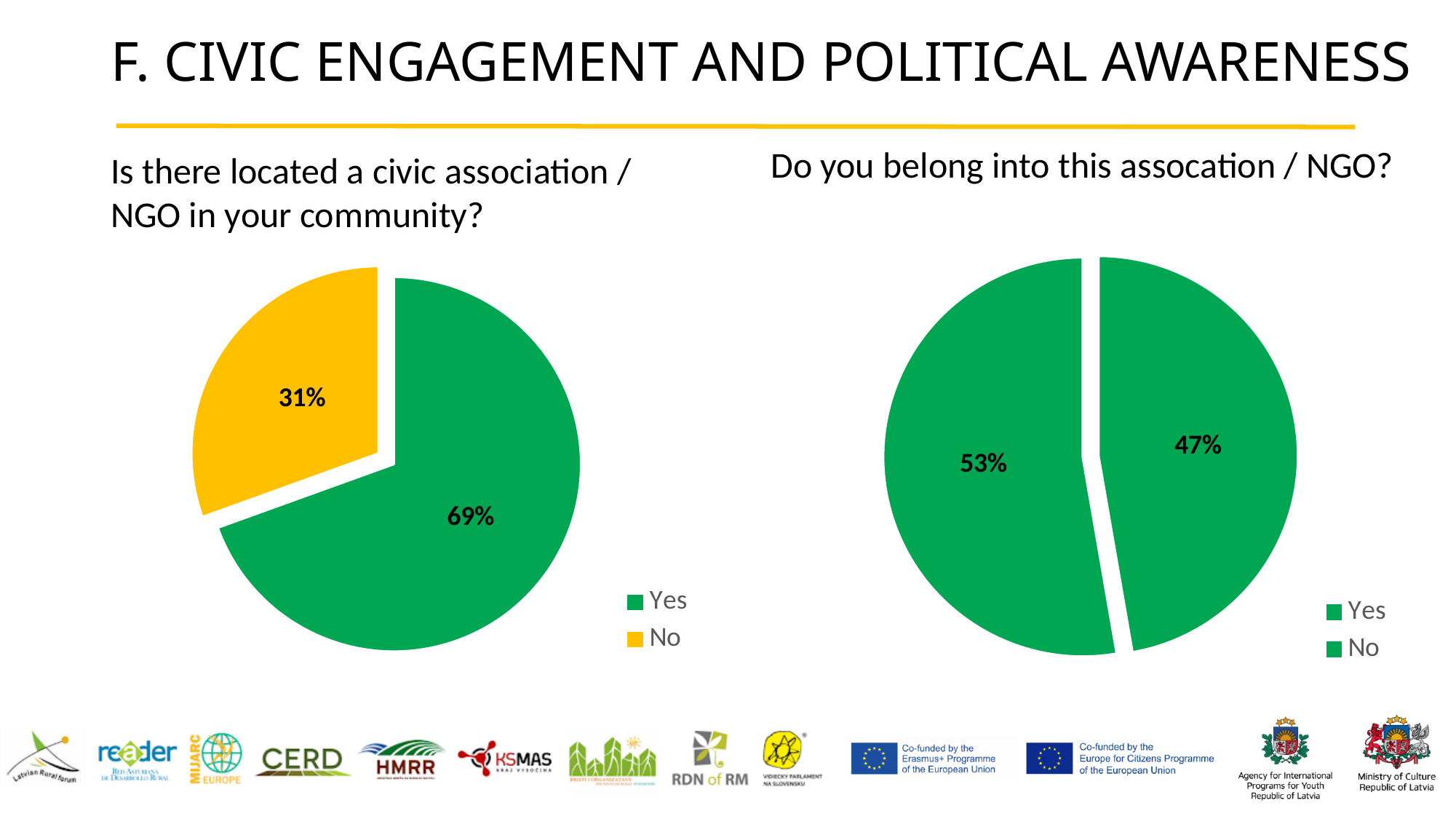
In the left pie chart (Is there located a civic association / NGO in your community?), is the share for Yes larger or smaller than the share for No? larger In the left pie chart (Is there located a civic association / NGO in your community?), which answer has the smallest share? No In the left pie chart (Is there located a civic association / NGO in your community?), what percentage answered No? 31% In the left pie chart (Is there located a civic association / NGO in your community?), which answer has the largest share? Yes In the right pie chart (Do you belong into this assocation / NGO?), what is the percentage shown on the larger slice? 53% In the left pie chart (Is there located a civic association / NGO in your community?), what colour is the No slice? yellow In the left pie chart (Is there located a civic association / NGO in your community?), what percentage answered Yes? 69% In the right pie chart (Do you belong into this assocation / NGO?), what is the difference in percentage points between the two slices? 6 In the right pie chart (Do you belong into this assocation / NGO?), what is the percentage shown on the smaller slice? 47% What type of chart is used for the question 'Do you belong into this assocation / NGO?'? pie chart How many entries does the legend of the left pie chart (Is there located a civic association / NGO in your community?) list? 2 In the left pie chart (Is there located a civic association / NGO in your community?), what is the difference in percentage points between Yes and No? 38